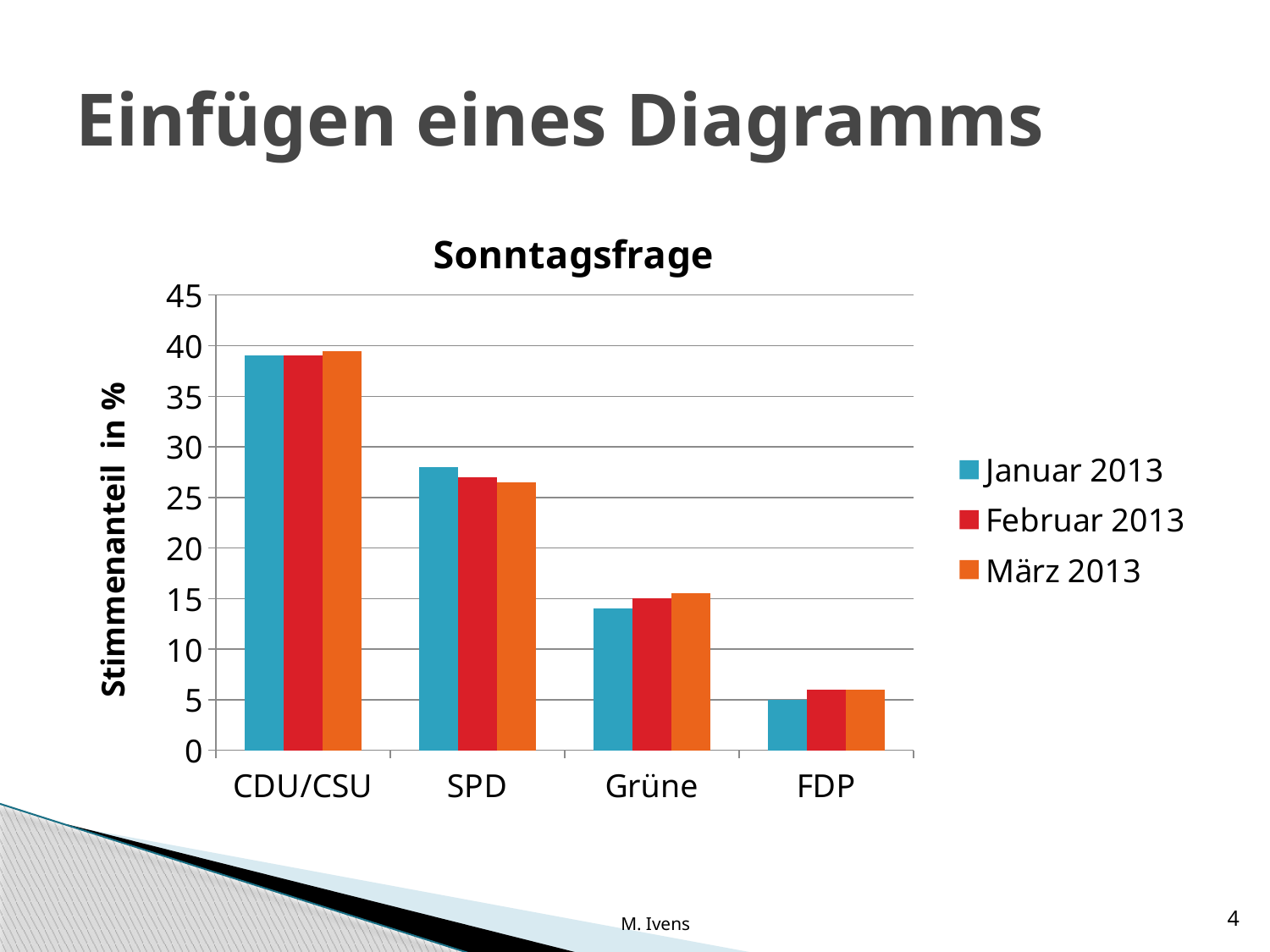
What is the label of the y axis? Stimmenanteil in % How many categories are shown on the x axis? 4 Which category has the highest values? CDU/CSU Is the value for SPD in Januar 2013 greater or less than 25? greater Is the value for FDP in Februar 2013 greater or less than 10? less Is the value for Grüne in Januar 2013 greater or less than 20? less What type of chart is shown on the slide? bar chart Which is larger, the value for SPD in Januar 2013 or the value for Grüne in Januar 2013? SPD in Januar 2013 How many series does the legend list? 3 Which category has the lowest values? FDP What is the title of the chart? Sonntagsfrage